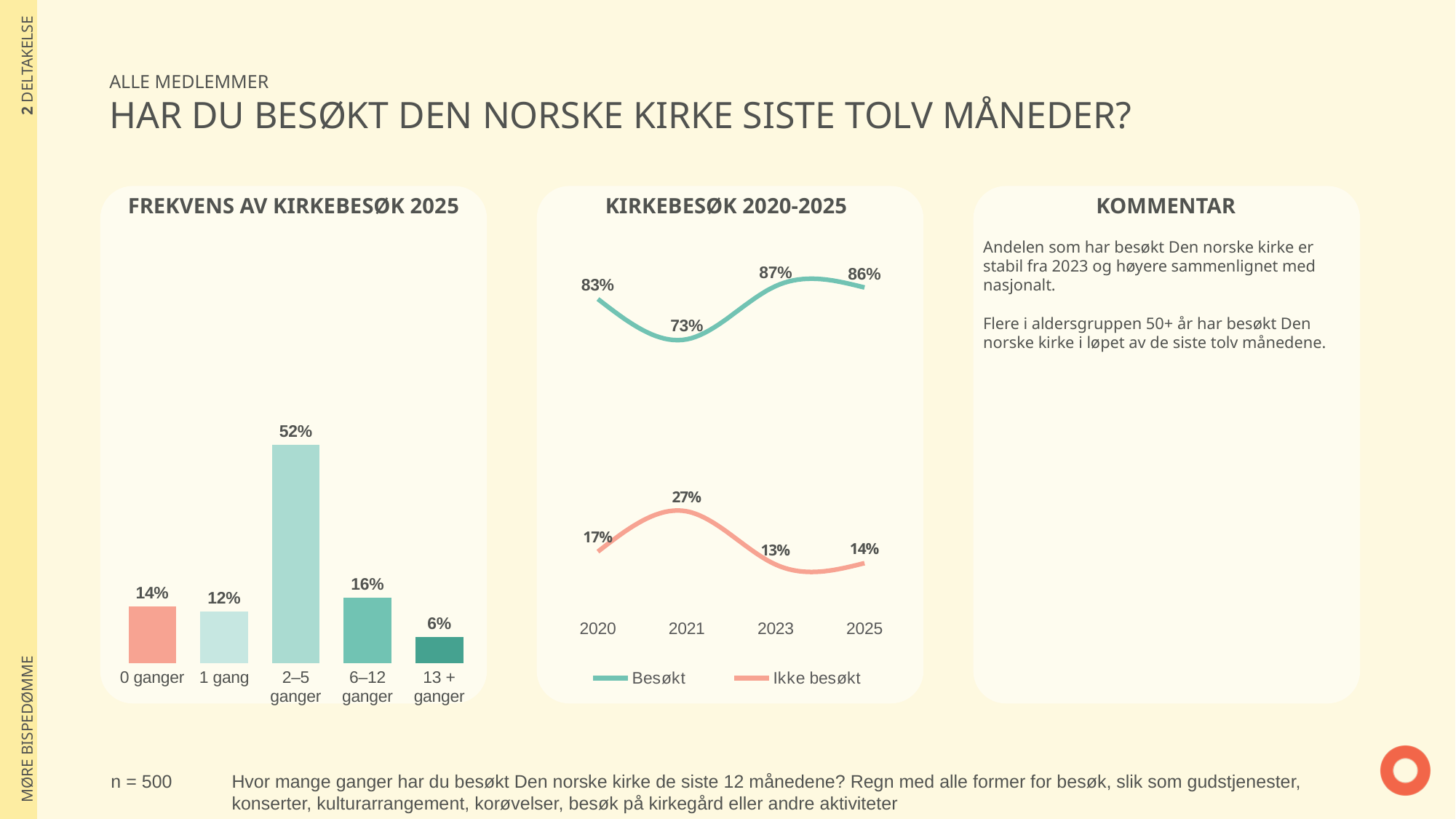
What kind of chart is 'KIRKEBESØK 2020-2025'? Line chart In the 'FREKVENS AV KIRKEBESØK 2025' chart, what is the difference between '6–12 ganger' and '1 gang'? 4% In the 'KIRKEBESØK 2020-2025' chart, in which year is 'Besøkt' highest? 2023 In the 'FREKVENS AV KIRKEBESØK 2025' chart, what is the value for '2–5 ganger'? 52% How many series does the legend of the 'KIRKEBESØK 2020-2025' chart list? 2 In the 'KIRKEBESØK 2020-2025' chart, what is the value for 'Ikke besøkt' in 2025? 14% In the 'KIRKEBESØK 2020-2025' chart, what is the value for 'Besøkt' in 2021? 73% In the 'FREKVENS AV KIRKEBESØK 2025' chart, which category has the highest value? 2–5 ganger What kind of chart is 'FREKVENS AV KIRKEBESØK 2025'? Bar chart In the 'FREKVENS AV KIRKEBESØK 2025' chart, which category has the lowest value? 13 + ganger In the 'FREKVENS AV KIRKEBESØK 2025' chart, how many categories are shown? 5 In the 'KIRKEBESØK 2020-2025' chart, what is the difference between 'Besøkt' in 2023 and in 2020? 4%